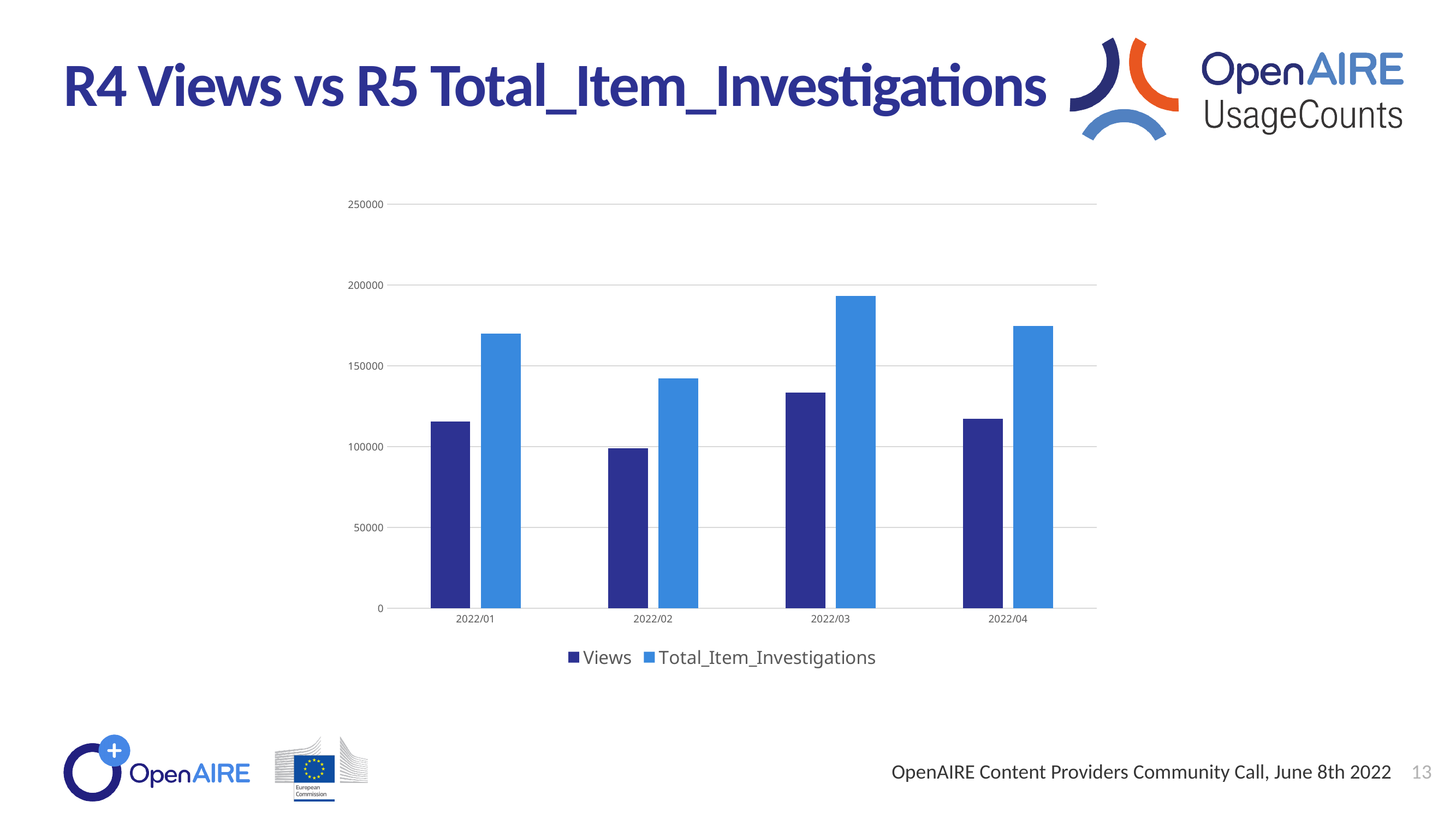
Which month has the lowest value for Total_Item_Investigations? 2022/02 Is the value for Total_Item_Investigations in 2022/01 greater or less than 150000? greater What kind of chart is shown on the slide? bar chart In 2022/02, which series has the larger value, Views or Total_Item_Investigations? Total_Item_Investigations How many months are shown on the x axis of the chart? 4 Which month has the highest value for Views? 2022/03 Which month has the lowest value for Views? 2022/02 Which month has the highest value for Total_Item_Investigations? 2022/03 What are the two series named in the chart's legend? Views and Total_Item_Investigations Is the value for Total_Item_Investigations in 2022/03 greater or less than 200000? less How many series does the chart's legend list? 2 Is the value for Views in 2022/03 greater or less than 100000? greater